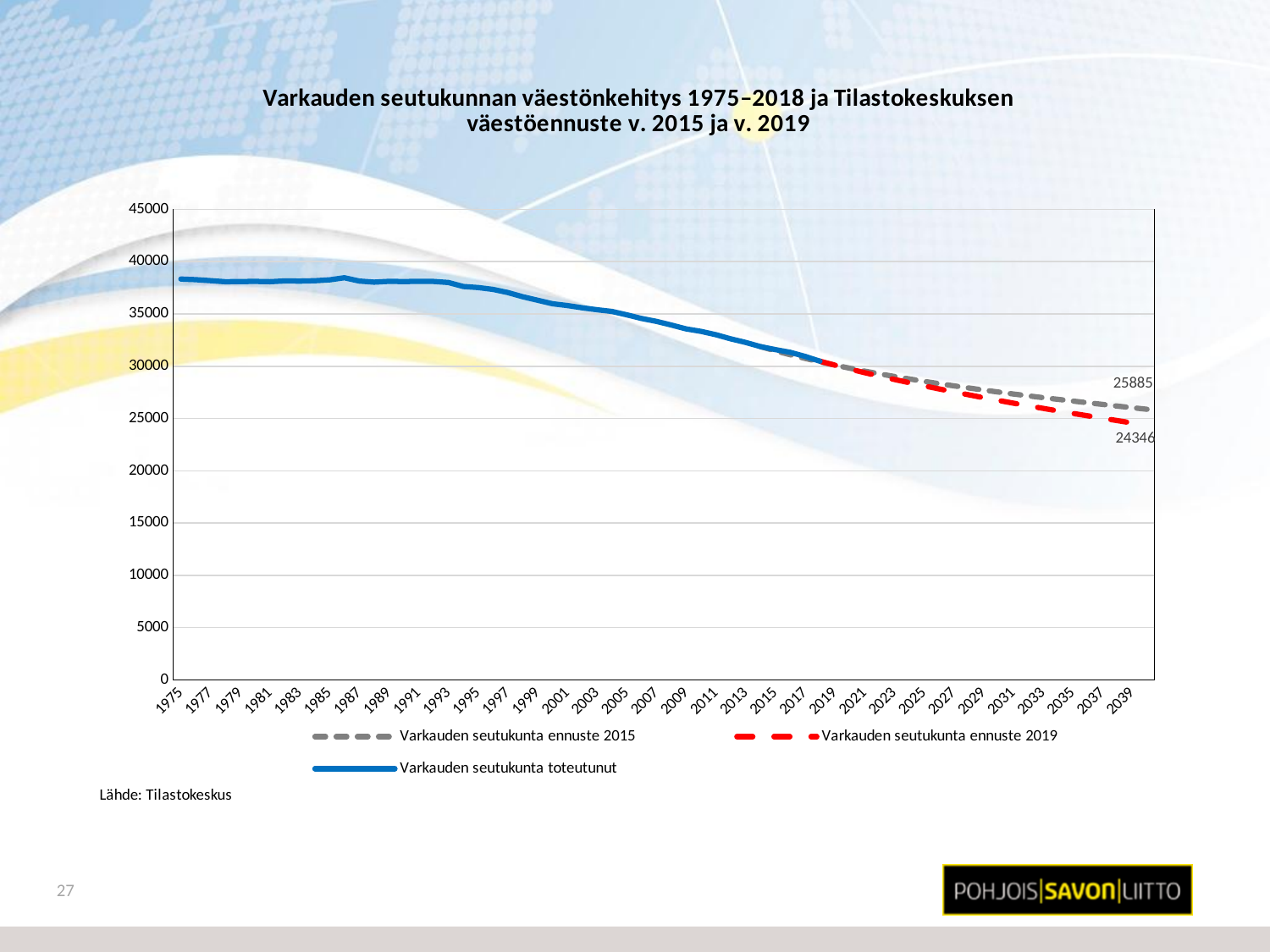
What is the source cited below the chart? Tilastokeskus Is the actual population value for 2005 greater or less than 30000? greater What is the difference between the end values of the 2015 forecast (25885) and the 2019 forecast (24346)? 1539 Is the actual population value for 1975 greater or less than 35000? greater What is the final labelled value of the 'Varkauden seutukunta ennuste 2019' series? 24346 How many series does the legend list? 3 What colour is the 'Varkauden seutukunta toteutunut' line? blue Is the actual population value for 2017 greater or less than 35000? less What kind of chart is shown on the slide? line chart Which forecast series ends at a higher value, 'ennuste 2015' or 'ennuste 2019'? Varkauden seutukunta ennuste 2015 What is the final labelled value of the 'Varkauden seutukunta ennuste 2015' series? 25885 Does the actual population ('toteutunut') series rise or fall overall from 1975 to 2018? fall